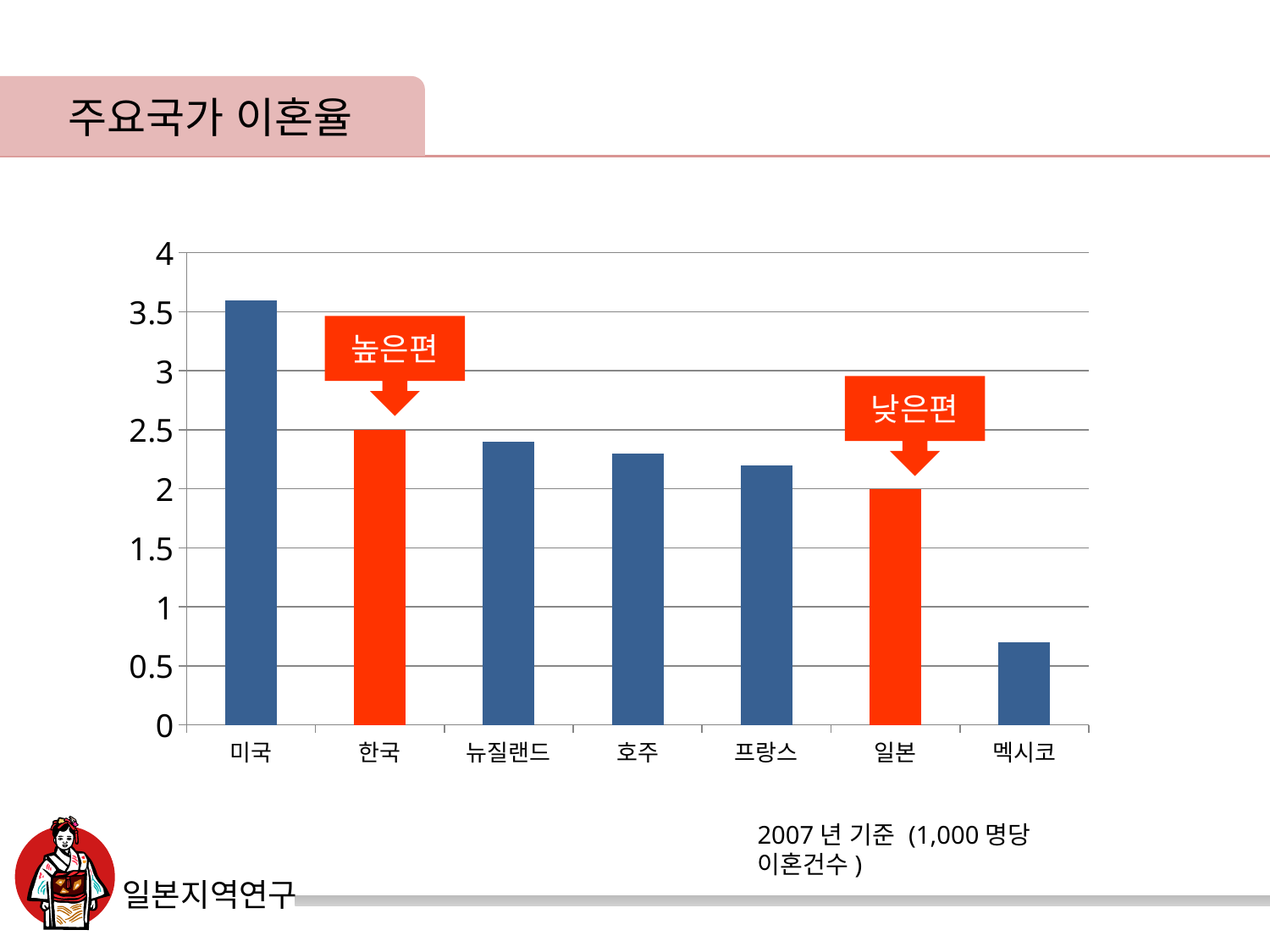
Do the values rise or fall from left to right along the x axis? fall What is the difference between the values for 한국 and 일본? 0.5 Is the value for 멕시코 greater or less than 1? less What is the value for 한국 in the chart? 2.5 How many countries are shown on the x axis of the chart? 7 What is the value for 일본 in the chart? 2 Which country has the highest divorce rate in the chart? 미국 What is the title of the chart on the slide? 주요국가 이혼율 What kind of chart is shown on the slide? bar chart Is the value for 미국 greater or less than 3? greater Which has a larger value, 미국 or 한국? 미국 Which country has the lowest divorce rate in the chart? 멕시코